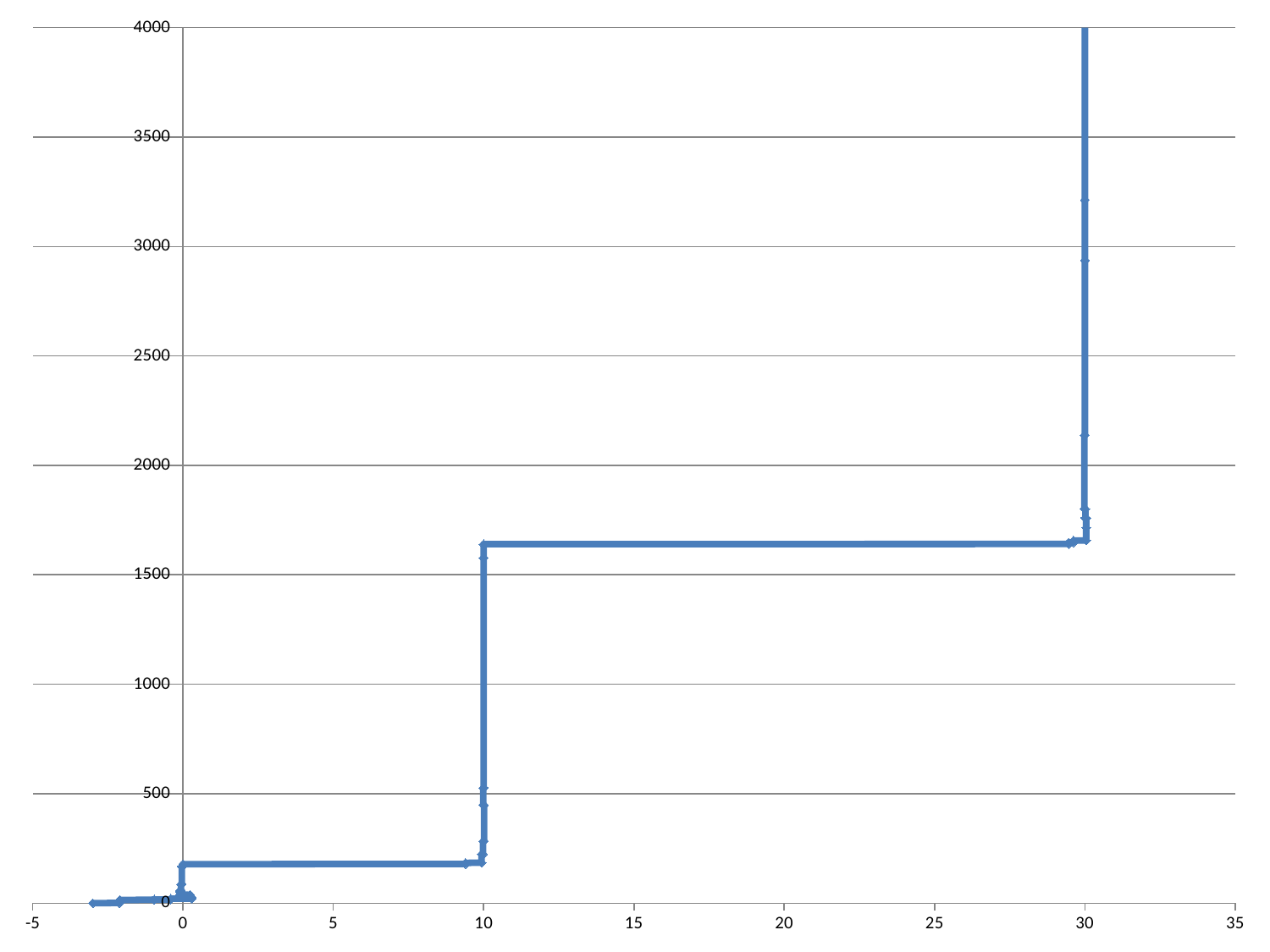
Is the plotted value at x = 20 larger than the plotted value at x = 5? yes What is the lowest value labelled on the horizontal axis? -5 What kind of chart is shown on the slide? line chart What is the maximum value shown on the vertical axis? 4000 Do the plotted values rise or fall as the x axis increases from -5 to 30? rise At which x value does the plotted line reach its highest point? 30 Is the plotted value at x = 25 greater or less than 2000? less Is the plotted value at x = 20 greater or less than 1500? greater Is the plotted value at x = -2 greater or less than 500? less